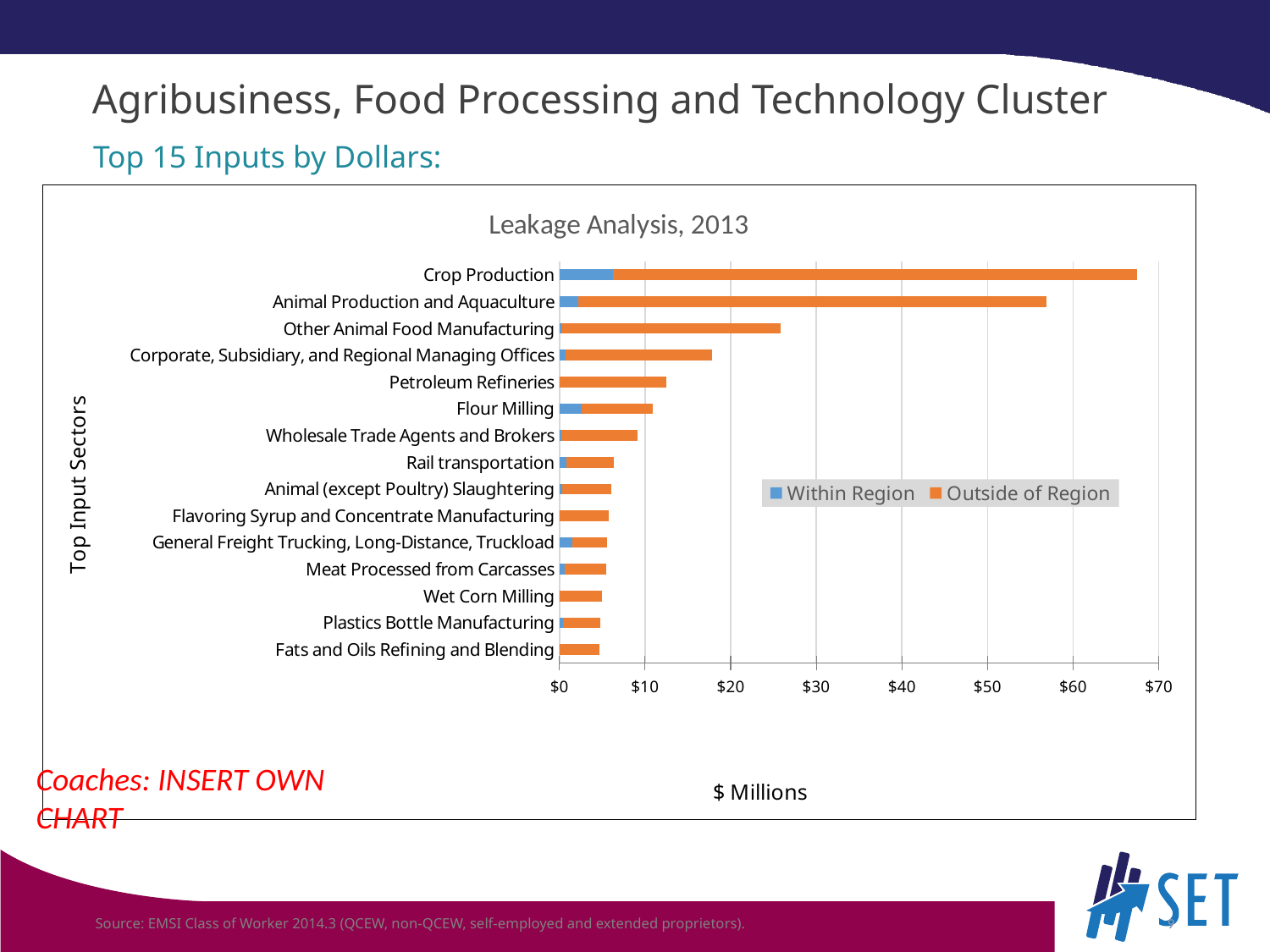
Is the total value for Wholesale Trade Agents and Brokers greater or less than $10? less What unit is shown on the x-axis label of the chart? $ Millions Which has a larger total value: Petroleum Refineries or Rail transportation? Petroleum Refineries Is the total value for Crop Production greater or less than $60? greater Which input sector has the longest bar in the chart? Crop Production What is the title of the chart? Leakage Analysis, 2013 Is the total value for Animal Production and Aquaculture greater or less than $50? greater Which has a larger total value: Other Animal Food Manufacturing or Corporate, Subsidiary, and Regional Managing Offices? Other Animal Food Manufacturing What type of chart is shown on the slide? Stacked bar chart How many series does the chart legend list? 2 How many input sectors are plotted in the chart? 15